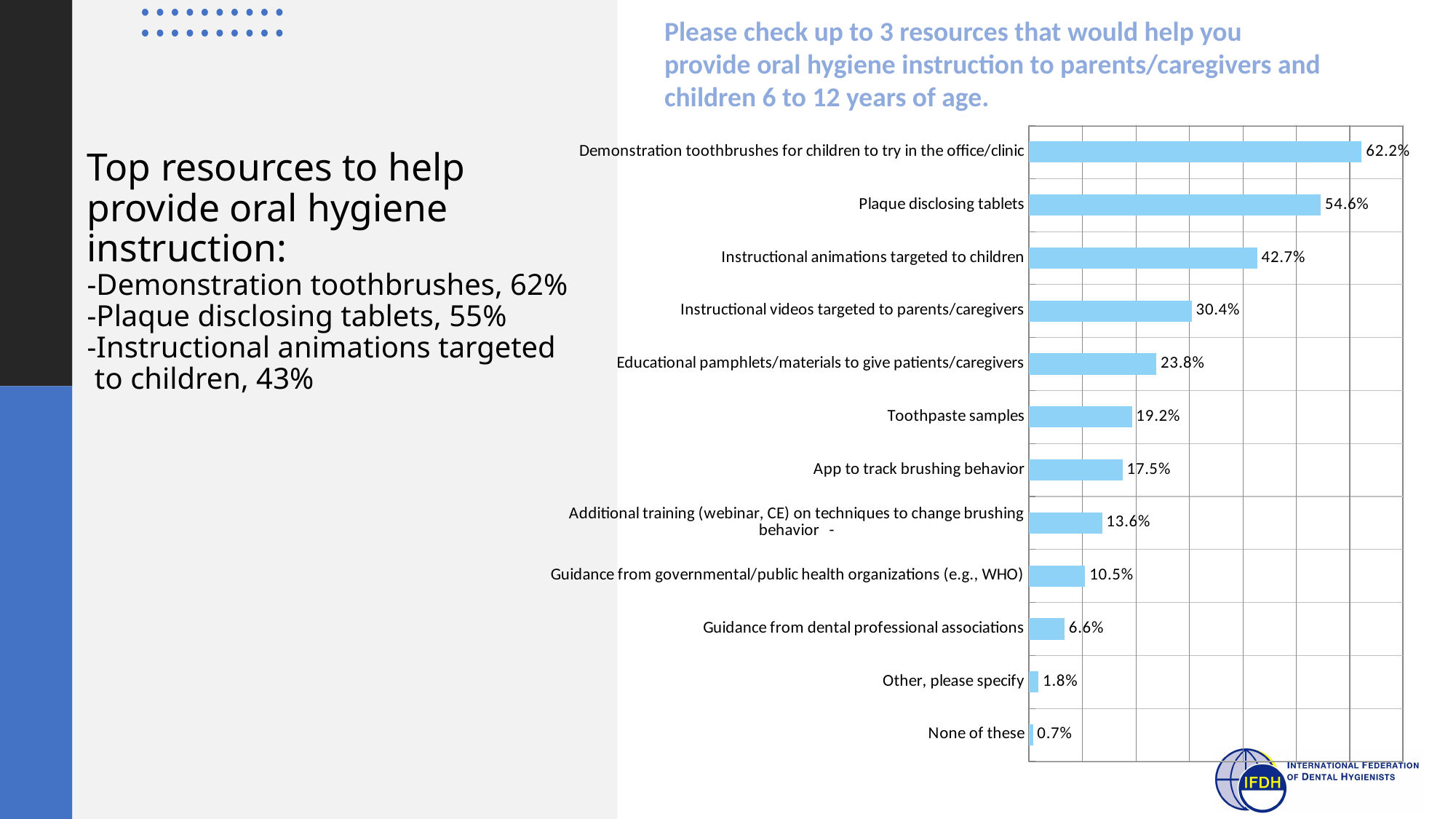
What percentage of respondents selected 'Plaque disclosing tablets'? 54.6% What is the value shown for 'Additional training (webinar, CE) on techniques to change brushing behavior'? 13.6% What type of chart is shown on the slide? Bar chart Which has a higher percentage: 'App to track brushing behavior' or 'Educational pamphlets/materials to give patients/caregivers'? Educational pamphlets/materials to give patients/caregivers Which category has the lowest percentage in the chart? None of these What is the difference between the percentages for 'Guidance from dental professional associations' and 'Other, please specify'? 4.8% How many categories are shown in the bar chart? 12 What is the difference between the percentages for 'Instructional animations targeted to children' and 'Instructional videos targeted to parents/caregivers'? 12.3% Which resource has the highest percentage in the chart? Demonstration toothbrushes for children to try in the office/clinic What percentage is shown for 'Guidance from governmental/public health organizations (e.g., WHO)'? 10.5% What colour are the bars in the chart? Light blue What is the value shown for 'Toothpaste samples'? 19.2%